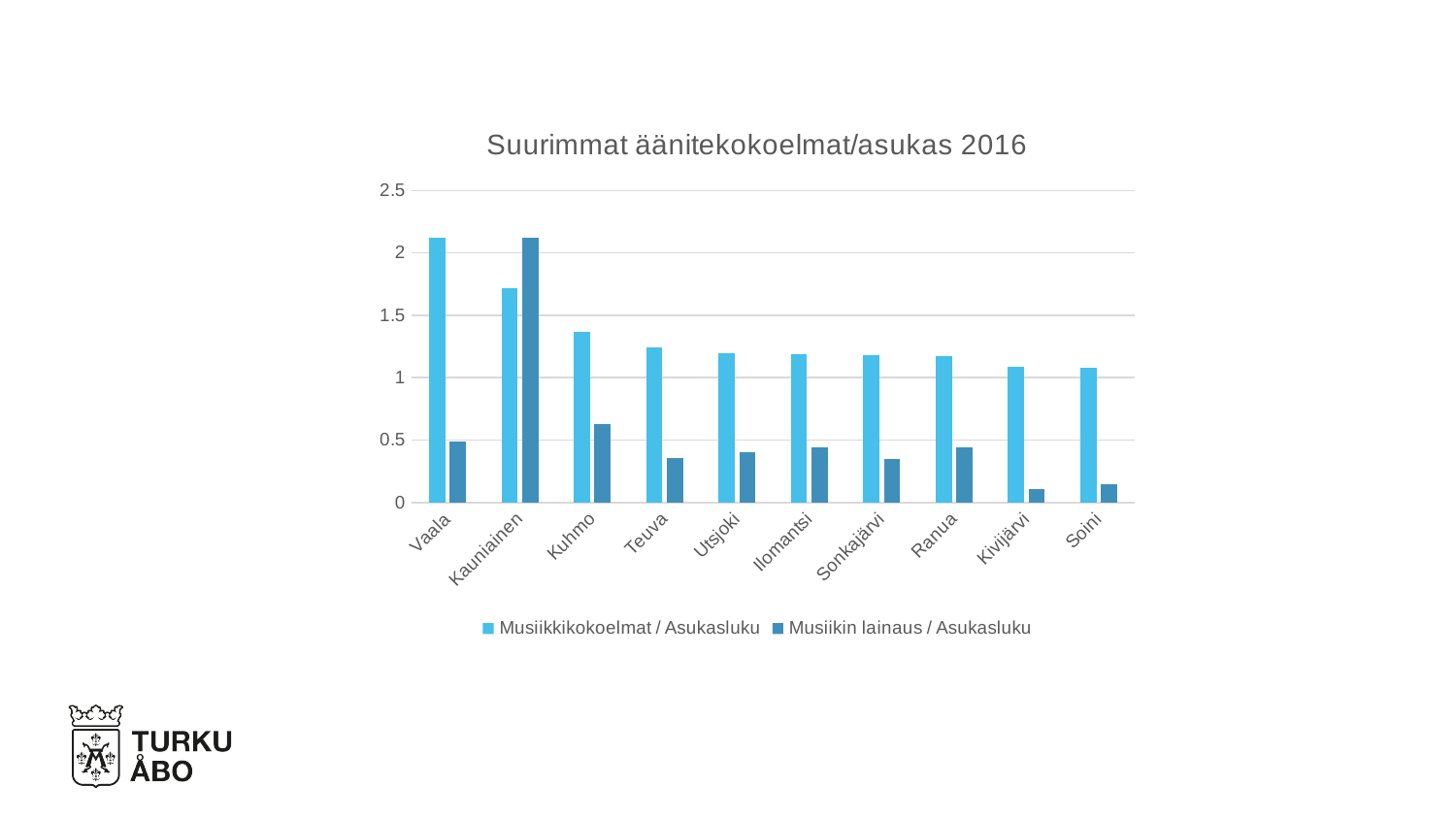
How many municipalities are shown on the x axis? 10 Is the Musiikin lainaus / Asukasluku value for Teuva greater or less than 0.5? less Which municipality has the highest value for Musiikkikokoelmat / Asukasluku? Vaala Is the Musiikkikokoelmat / Asukasluku value for Kuhmo greater or less than 1.5? less What kind of chart is shown on the slide? bar chart How many series does the legend list? 2 Which municipality has the highest value for Musiikin lainaus / Asukasluku? Kauniainen Do the Musiikkikokoelmat / Asukasluku values rise or fall from left to right along the x axis? fall What is the title of the chart? Suurimmat äänitekokoelmat/asukas 2016 Which is larger for Kauniainen: Musiikkikokoelmat / Asukasluku or Musiikin lainaus / Asukasluku? Musiikin lainaus / Asukasluku Is the Musiikkikokoelmat / Asukasluku value for Vaala greater or less than 2? greater Which municipality has the larger Musiikin lainaus / Asukasluku value, Vaala or Kauniainen? Kauniainen